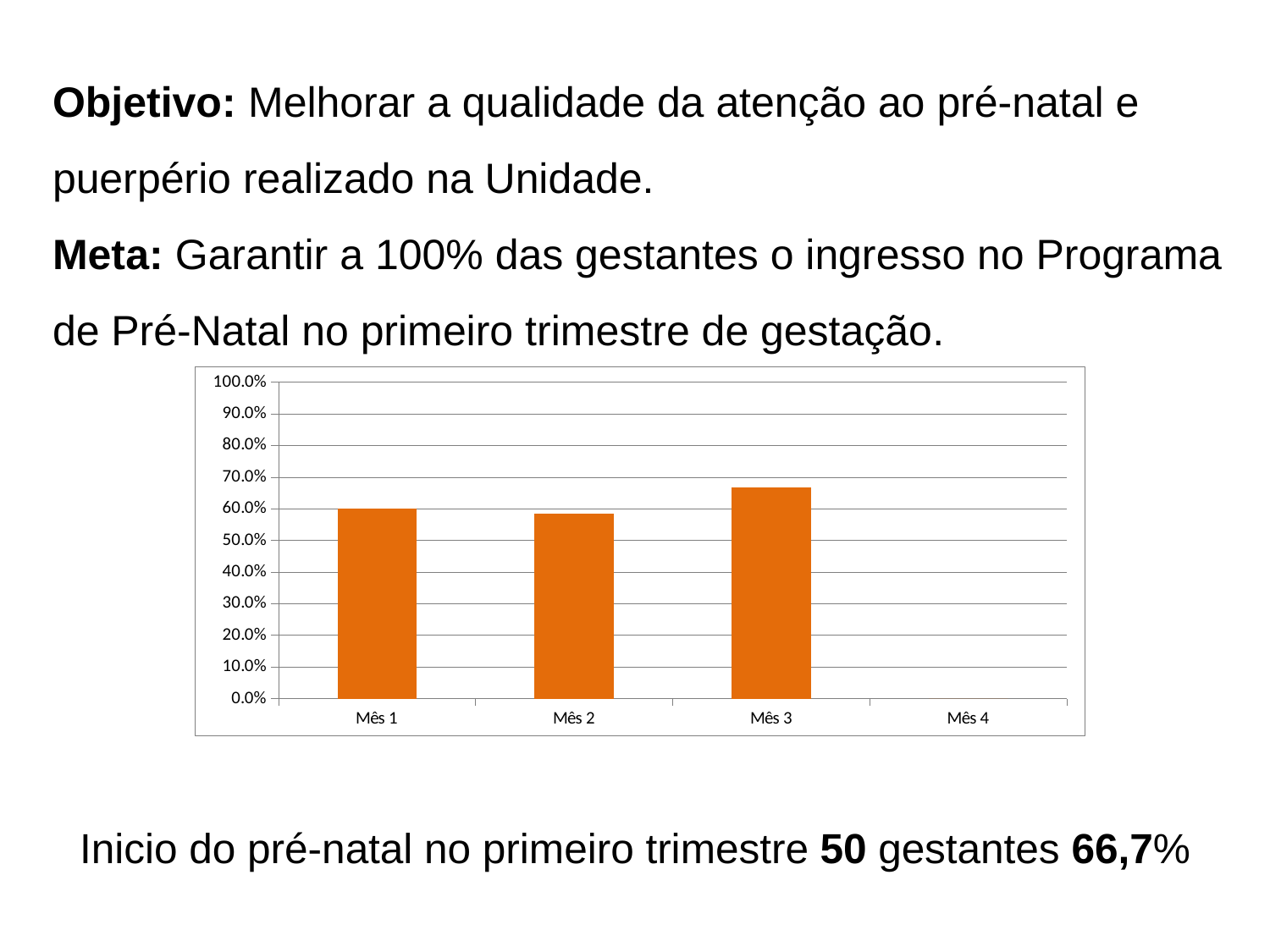
Which is larger, the value for Mês 3 or the value for Mês 2? Mês 3 Is the value for Mês 1 greater or less than 50.0%? greater Which month has the highest bar in the chart? Mês 3 How many categories are shown on the x axis of the chart? 4 Is the value for Mês 3 greater or less than 70.0%? less Which month has no visible bar in the chart? Mês 4 What is the highest value shown on the y axis of the chart? 100.0% What kind of chart is shown on the slide? bar chart What colour are the bars in the chart? orange Is the value for Mês 3 greater or less than 60.0%? greater